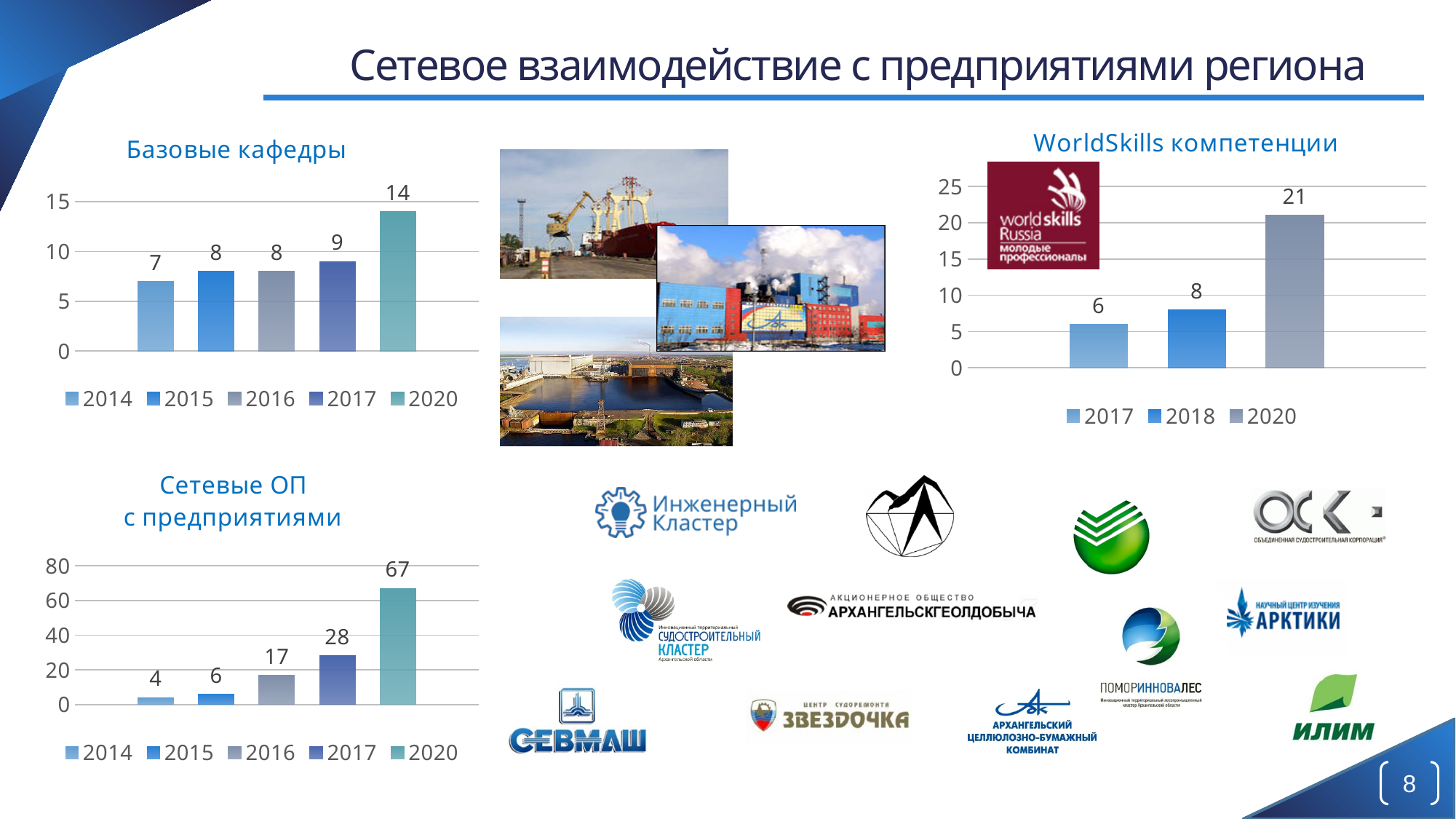
In the 'Сетевые ОП с предприятиями' chart, what is the value for 2017? 28 In the 'Сетевые ОП с предприятиями' chart, what is the difference between the values for 2020 and 2016? 50 In the 'WorldSkills компетенции' chart, is the value for 2020 greater or less than 20? greater In the 'Базовые кафедры' chart, what is the value for 2014? 7 In the 'Базовые кафедры' chart, what is the difference between the values for 2020 and 2017? 5 What type of chart is the 'Сетевые ОП с предприятиями' chart? bar chart In the 'WorldSkills компетенции' chart, how many years does the legend list? 3 In the 'WorldSkills компетенции' chart, what is the value for 2018? 8 In the 'Сетевые ОП с предприятиями' chart, do the values rise or fall from 2014 to 2020? rise In the 'Базовые кафедры' chart, what is the value for 2020? 14 In the 'WorldSkills компетенции' chart, which year has the lowest value? 2017 In the 'Базовые кафедры' chart, which year has the highest value? 2020